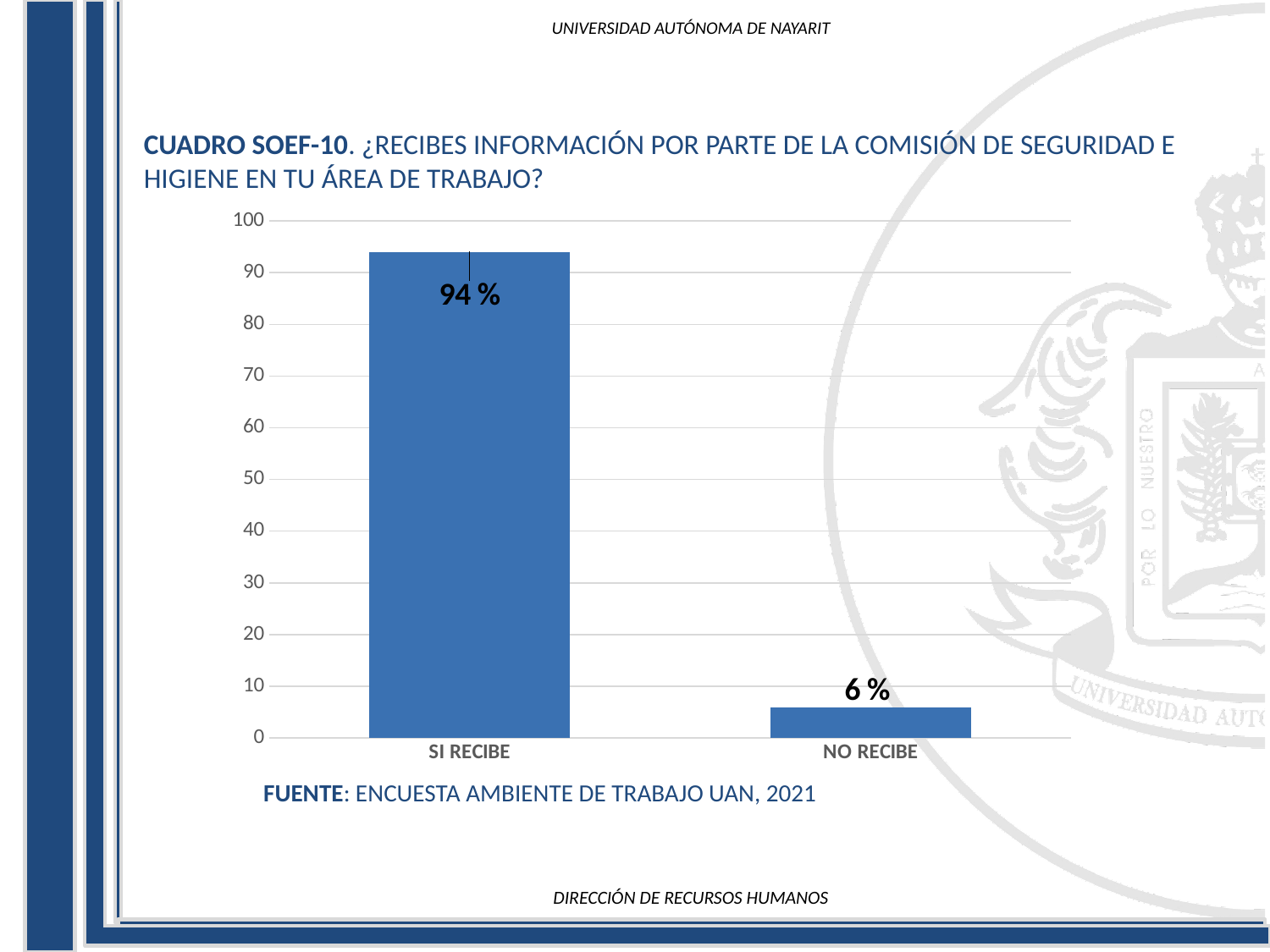
Which category has the highest value? SI RECIBE What is the maximum value shown on the y axis? 100 Which category has the lowest value? NO RECIBE What is the source cited below the chart? ENCUESTA AMBIENTE DE TRABAJO UAN, 2021 What kind of chart is shown on the slide? bar chart What is the value for SI RECIBE? 94 % How many categories are shown on the x axis? 2 Which is larger, the value for SI RECIBE or the value for NO RECIBE? SI RECIBE What is the value for NO RECIBE? 6 % Is the value for NO RECIBE greater or less than 10? less What is the difference between the values for SI RECIBE and NO RECIBE? 88 % Is the value for SI RECIBE greater or less than 90? greater